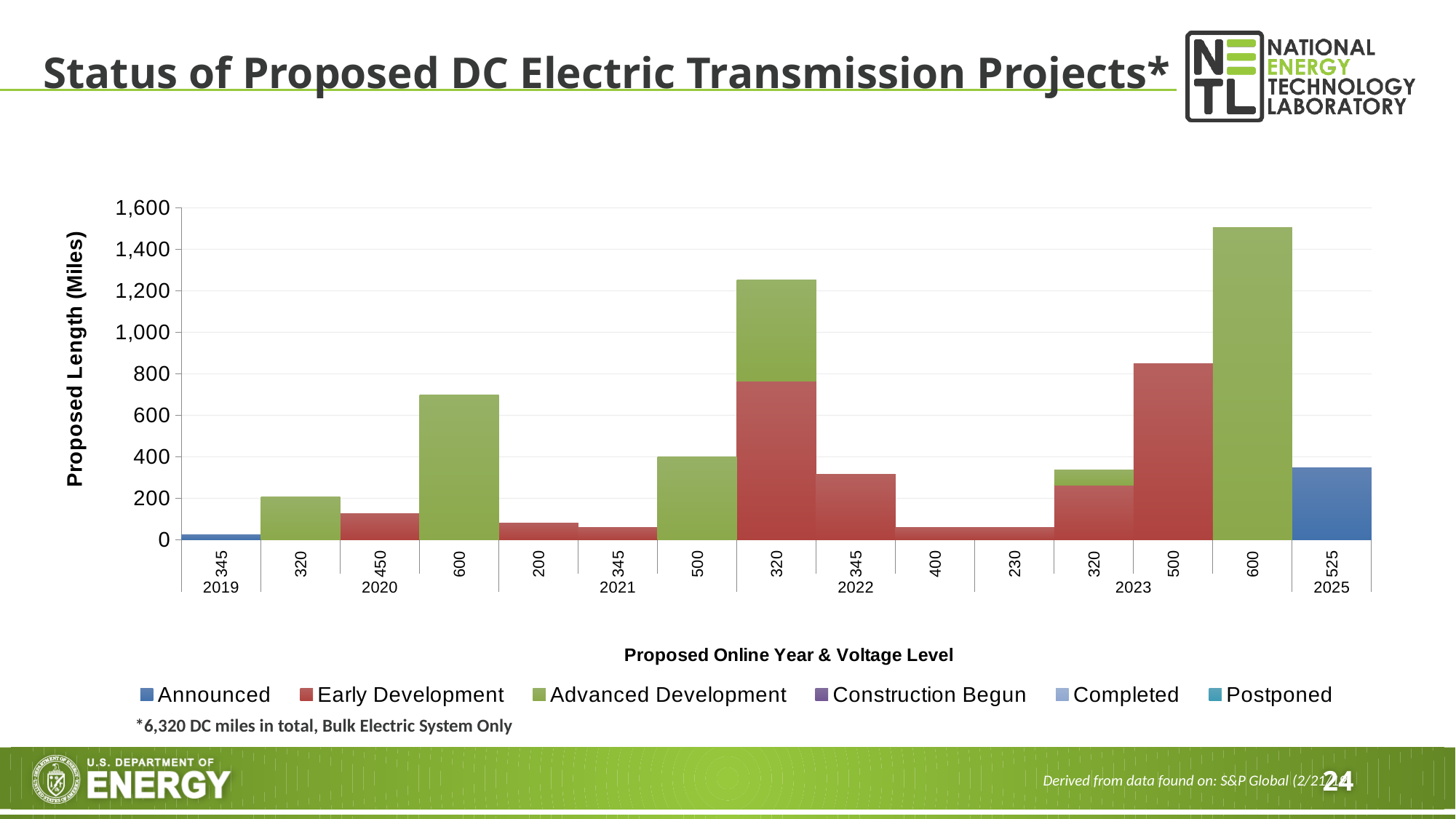
Which bar is taller: 600 in 2020 or 320 in 2022? 320 in 2022 Which series is shown in green in the legend? Advanced Development What is the title of the y axis? Proposed Length (Miles) How many series does the legend list? 6 How many bars (year and voltage level categories) are plotted on the x axis? 15 Which year and voltage level category has the tallest bar? 600 in 2023 Is the bar for 600 in 2020 greater or less than 600 miles? greater Is the total bar for 320 in 2022 greater or less than 1,200 miles? greater Which year and voltage level category has the shortest bar? 345 in 2019 Is the bar for 525 in 2025 greater or less than 400 miles? less What kind of chart is shown on the slide? Stacked bar chart